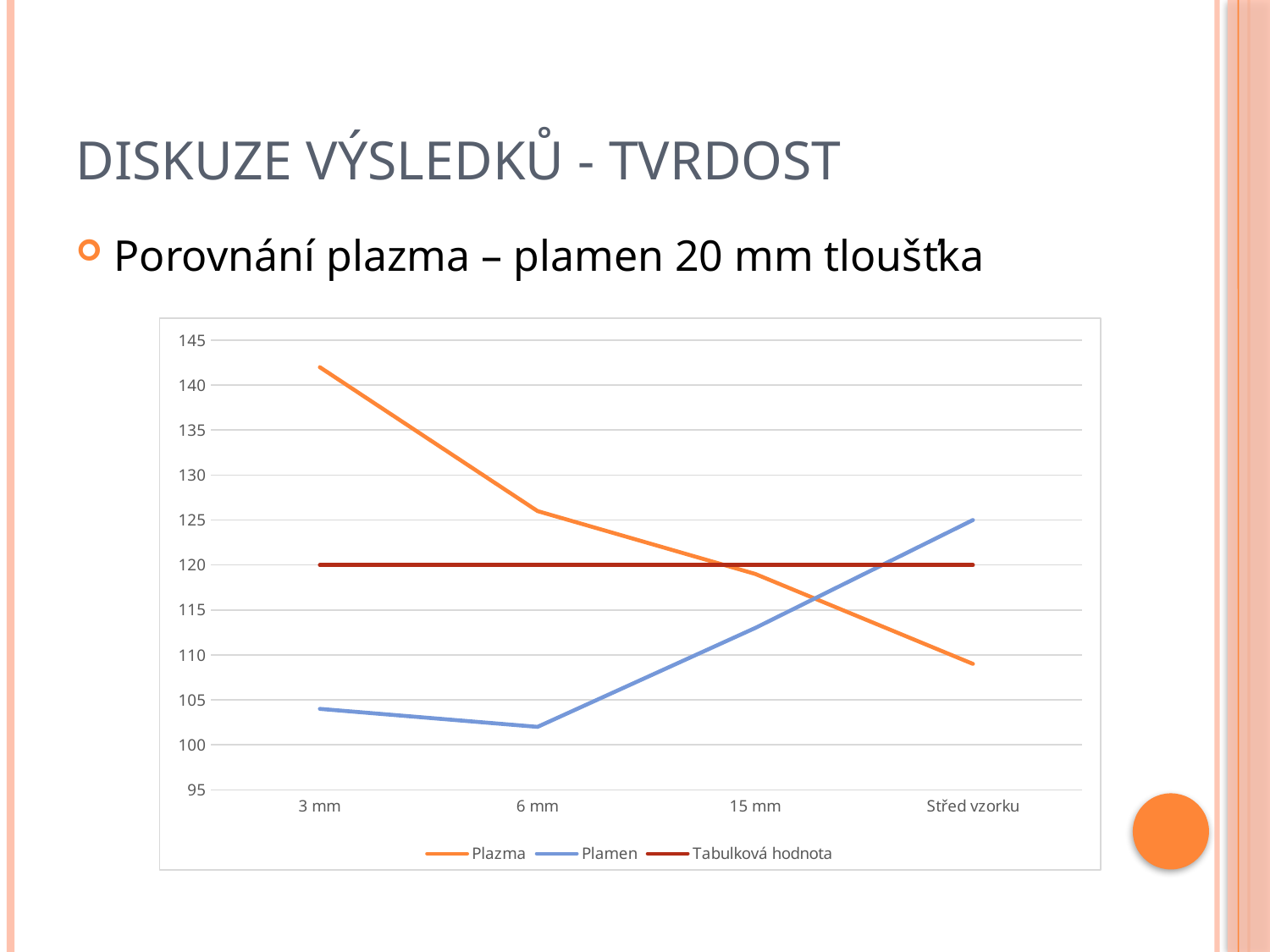
Is the value for Plazma at 3 mm greater or less than 140? greater Is the value for Plazma at Střed vzorku greater or less than 115? less How many series does the legend list? 3 Is the value for Plazma at 6 mm greater or less than 130? less At which category does the Plazma series reach its highest value? 3 mm How many categories are shown on the x axis? 4 Does the Plazma series rise or fall from 3 mm to Střed vzorku? fall At 3 mm, which series has the larger value, Plazma or Plamen? Plazma What is the value of the Tabulková hodnota series at 15 mm? 120 What kind of chart is shown on the slide? line chart At Střed vzorku, which series has the larger value, Plazma or Plamen? Plamen